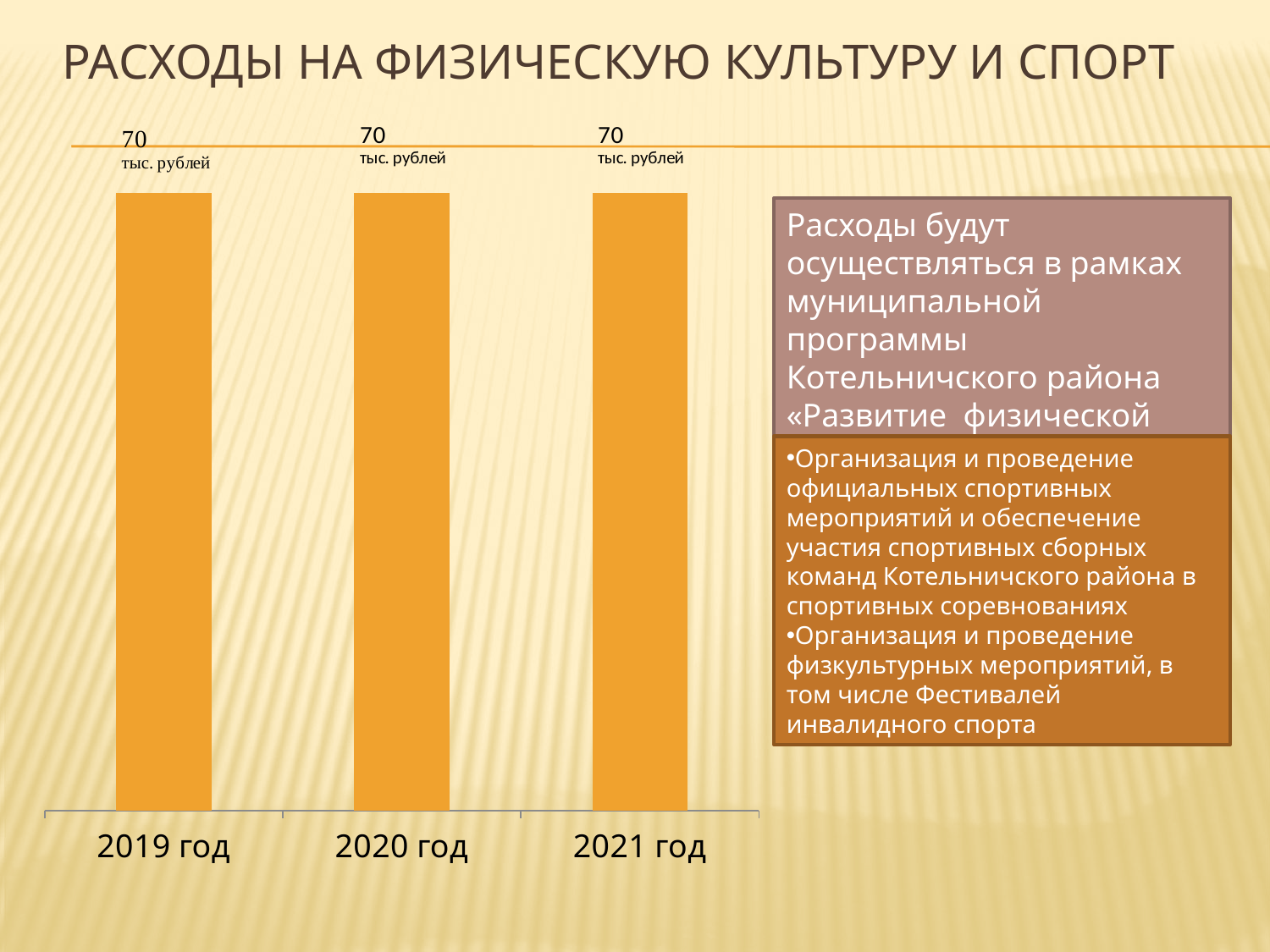
Is the value for 2020 год greater or less than 50 тыс. рублей? greater Do the values rise, fall or stay the same from 2019 год to 2021 год? Stay the same In what unit are the values on the chart expressed? тыс. рублей What kind of chart is shown on the slide? Bar chart What is the difference between the values for 2020 год and 2021 год? 0 What is the difference between the values for 2019 год and 2021 год? 0 What is the title of the slide containing the chart? РАСХОДЫ НА ФИЗИЧЕСКУЮ КУЛЬТУРУ И СПОРТ What colour are the bars on the chart? Orange How many categories are shown on the chart? 3 What is the value for 2020 год? 70 тыс. рублей What is the value for 2019 год? 70 тыс. рублей What is the value for 2021 год? 70 тыс. рублей